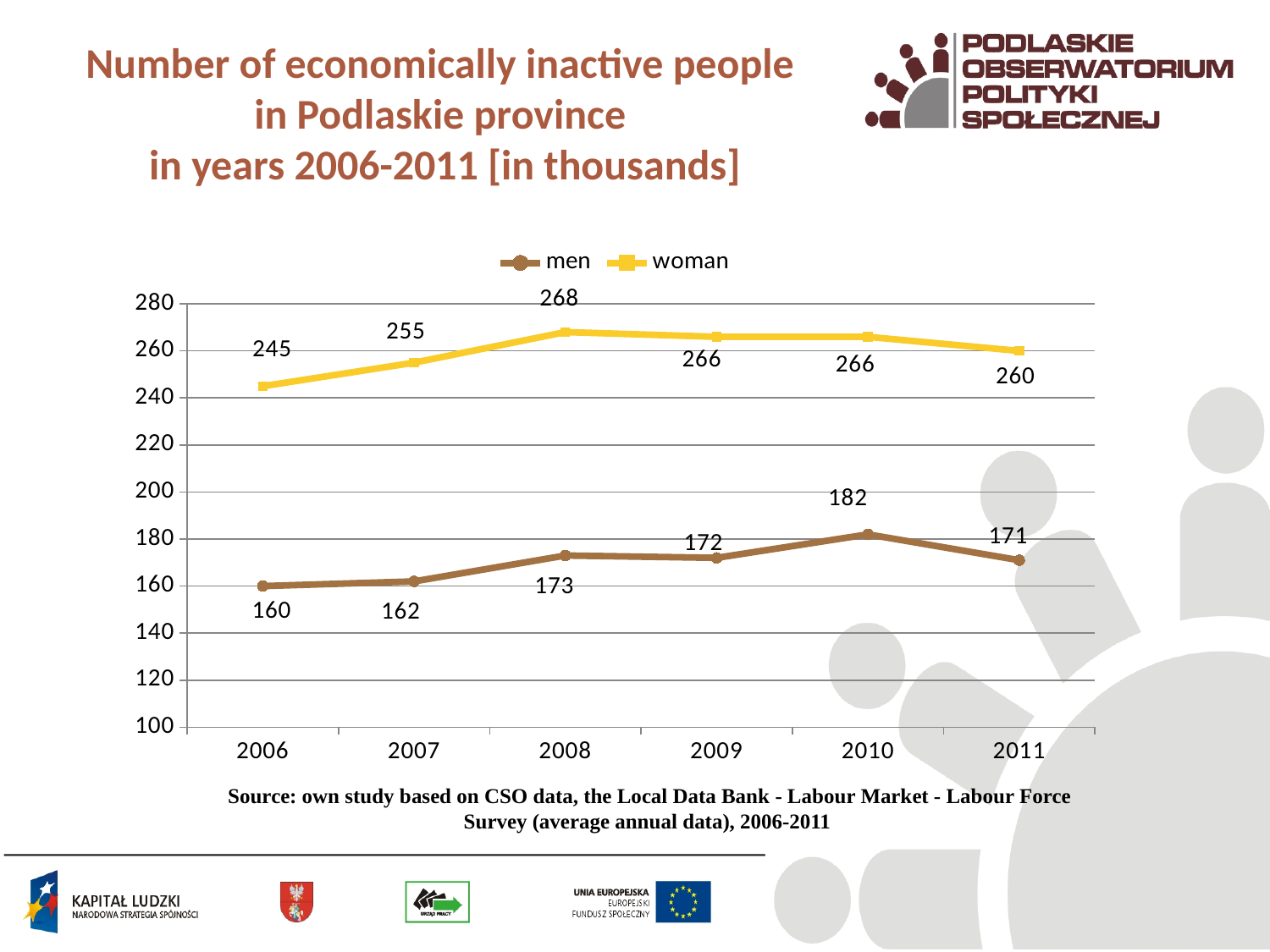
In which year is the value for men lowest? 2006 What is the value for woman in 2008? 268 How many series does the legend list? 2 What is the value for men in 2010? 182 What is the difference between the woman and men values in 2011? 89 What is the value for men in 2006? 160 Which is larger, the men value in 2009 or the men value in 2011? 2009 Does the value for woman rise or fall from 2010 to 2011? fall What kind of chart is shown? line chart How many years are shown on the x axis? 6 Is the value for woman in 2006 greater or less than 240? greater In which year is the value for woman highest? 2008